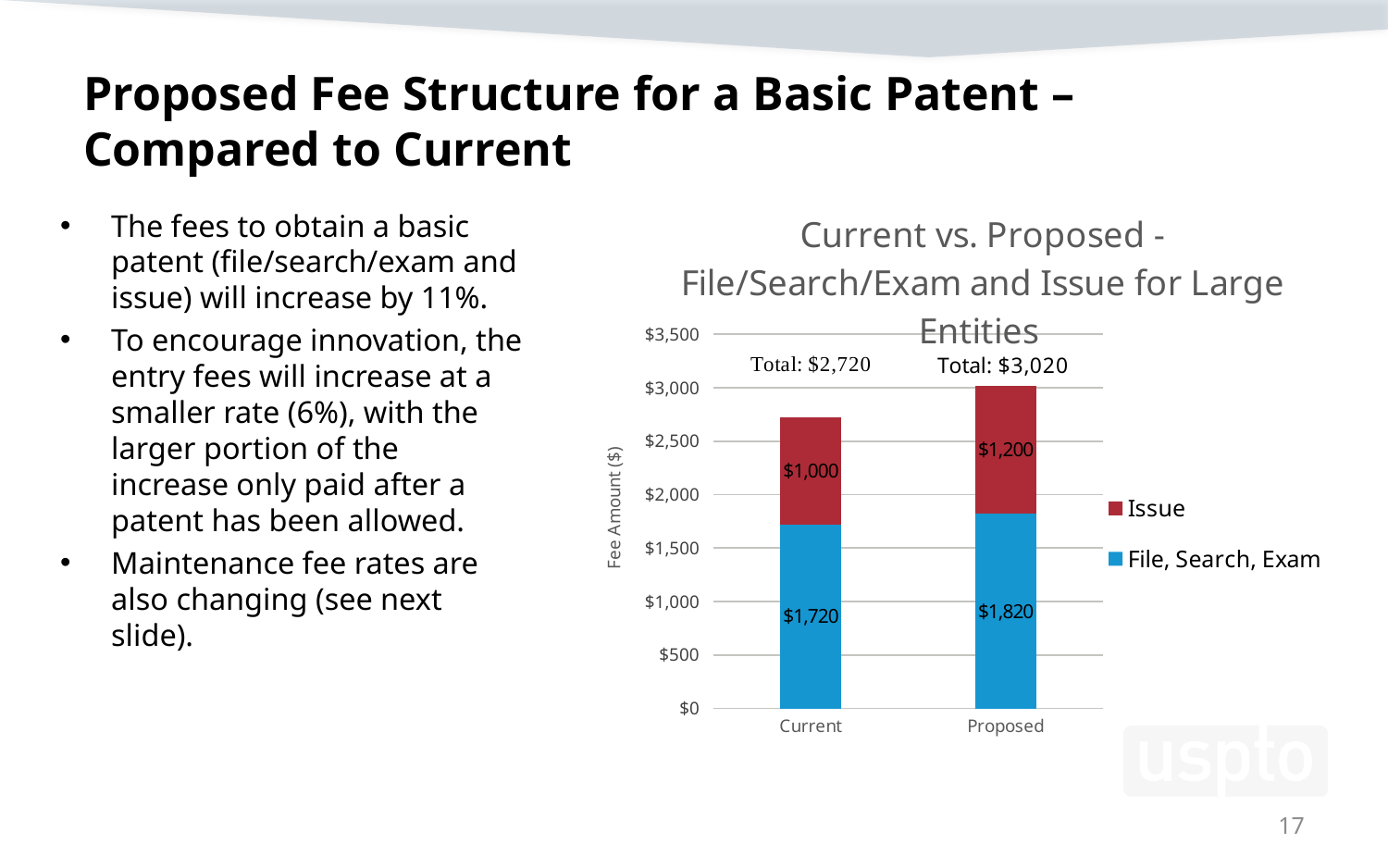
What is the label of the vertical axis? Fee Amount ($) What is the Issue fee for the Current bar? $1,000 Which bar has the larger total, Current or Proposed? Proposed What kind of chart is shown on the slide? Stacked bar chart What is the total of the Proposed stacked bar? $3,020 What is the difference between the Proposed and Current File, Search, Exam fees? $100 What is the difference between the Proposed and Current Issue fees? $200 What is the File, Search, Exam fee for the Current bar? $1,720 What is the Issue fee for the Proposed bar? $1,200 What is the total of the Current stacked bar? $2,720 What is the File, Search, Exam fee for the Proposed bar? $1,820 How many series does the legend list? 2